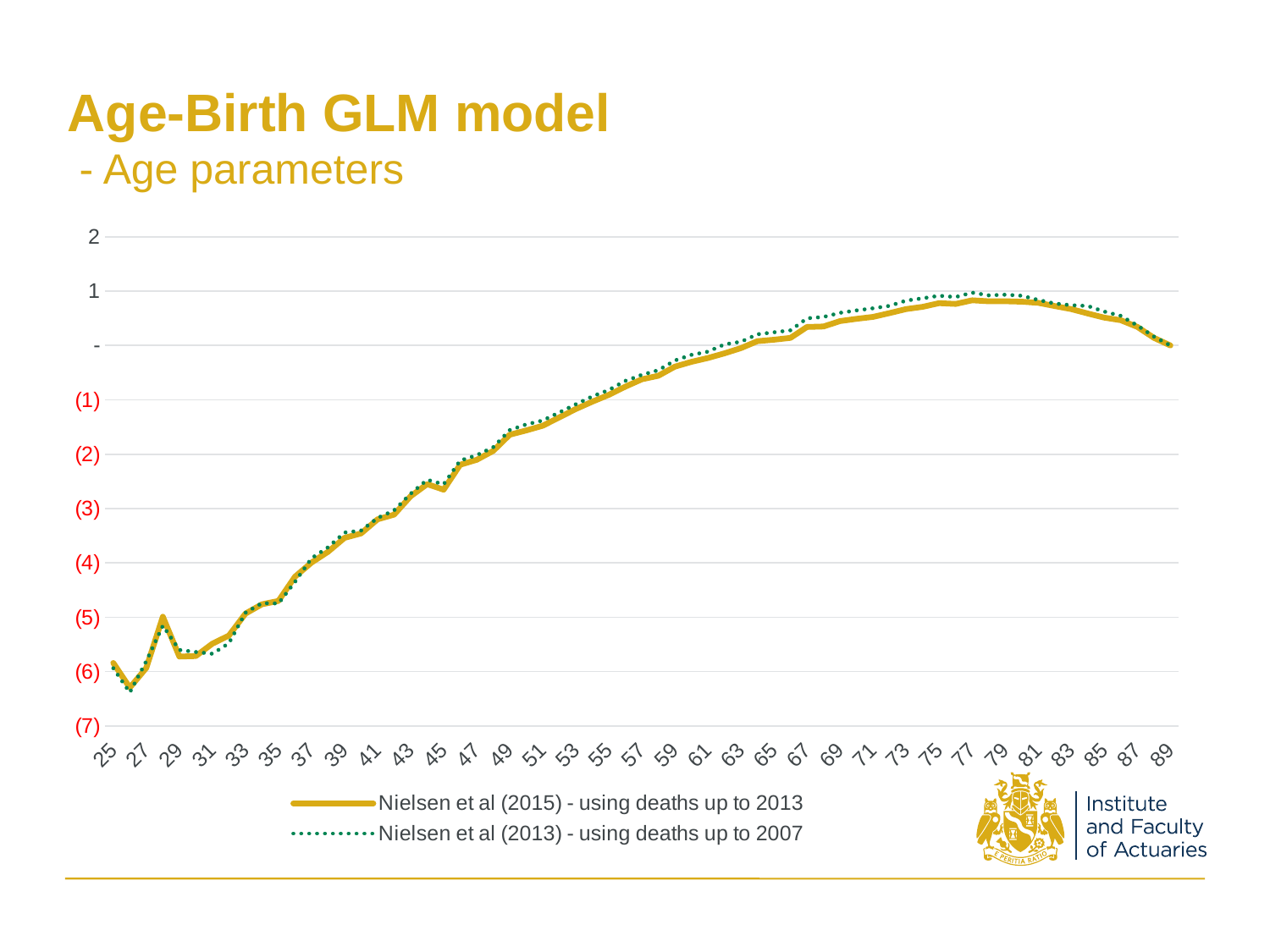
Is the value for age 53 in the Nielsen et al (2015) series greater or less than (1)? less Do the age parameter values generally rise or fall from age 25 to age 75? rise Is the value for age 45 in the Nielsen et al (2015) series greater or less than (2)? less How many series does the legend list? 2 Is the value for age 57 in the Nielsen et al (2015) series greater or less than 0? less What is the title of the slide's chart section? Age-Birth GLM model - Age parameters How many age labels are shown on the x axis? 33 Which series is drawn as a dotted line? Nielsen et al (2013) - using deaths up to 2007 What kind of chart is shown on the slide? line chart